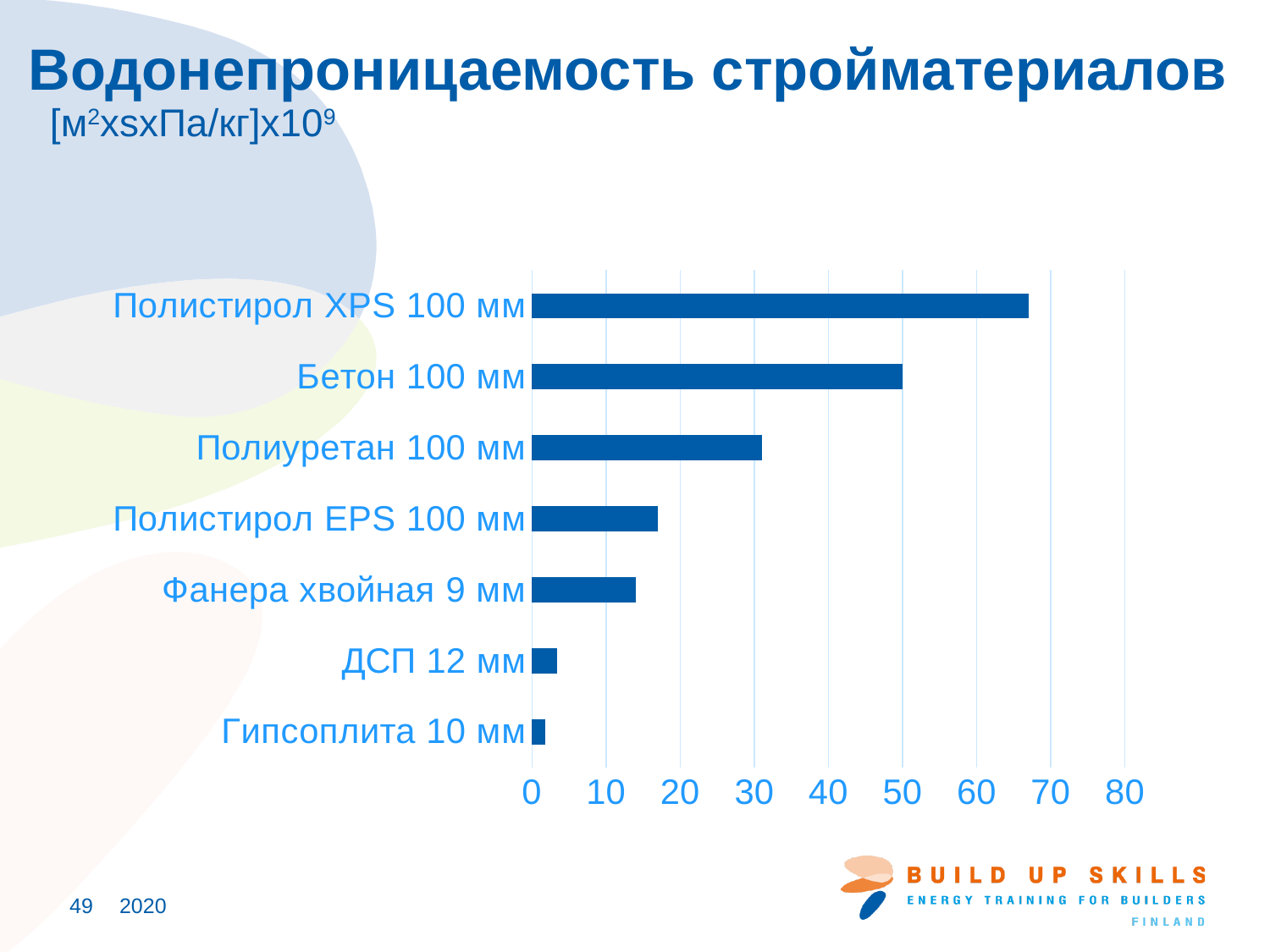
What is the title of the slide containing the chart? Водонепроницаемость стройматериалов What kind of chart is shown on the slide? bar chart Which material has the highest water vapour resistance value on the chart? Полистирол XPS 100 мм Is the value for ДСП 12 мм greater or less than 10? less Is the value for Полистирол EPS 100 мм greater or less than 20? less Is the value for Полиуретан 100 мм greater or less than 20? greater Which has the larger value, Полистирол EPS 100 мм or ДСП 12 мм? Полистирол EPS 100 мм Which has the larger value, Бетон 100 мм or Полиуретан 100 мм? Бетон 100 мм Which material has the lowest value on the chart? Гипсоплита 10 мм How many building materials are listed on the chart? 7